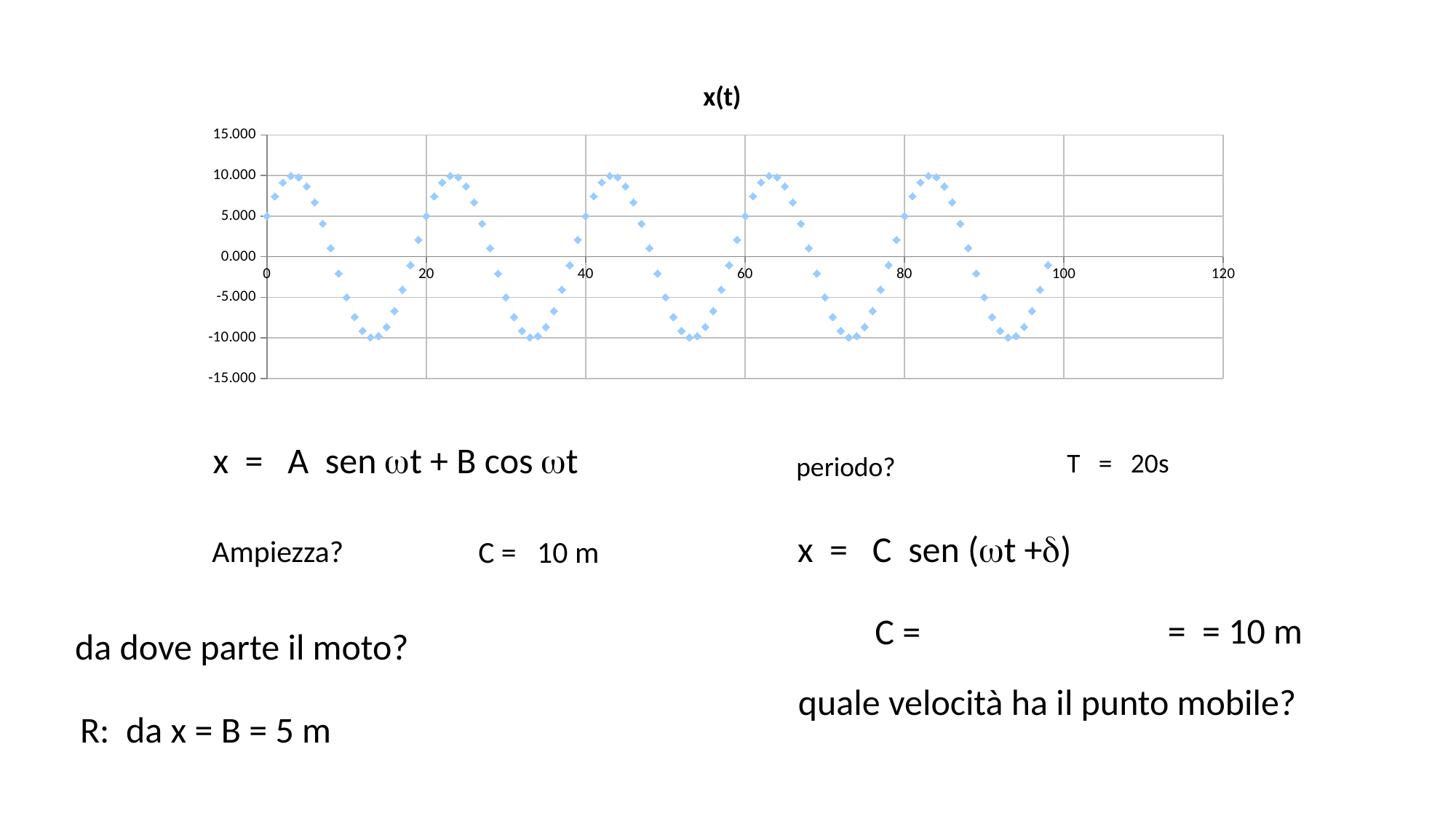
Is the value of x(t) at t = 10 greater or less than 0.000? less Which is larger, the value of x(t) at t = 5 or at t = 15? t = 5 What is the highest value labelled on the vertical axis of the chart? 15.000 What is the title of the chart? x(t) What kind of chart is shown on the slide? scatter chart What is the value of x(t) at t = 0? 5.000 Is the value of x(t) at t = 5 greater or less than 5.000? greater How many tick labels are shown on the horizontal axis of the chart? 7 Is the value of x(t) at t = 15 greater or less than -5.000? less Do the plotted values rise steadily, fall steadily, or oscillate along the x axis? oscillate